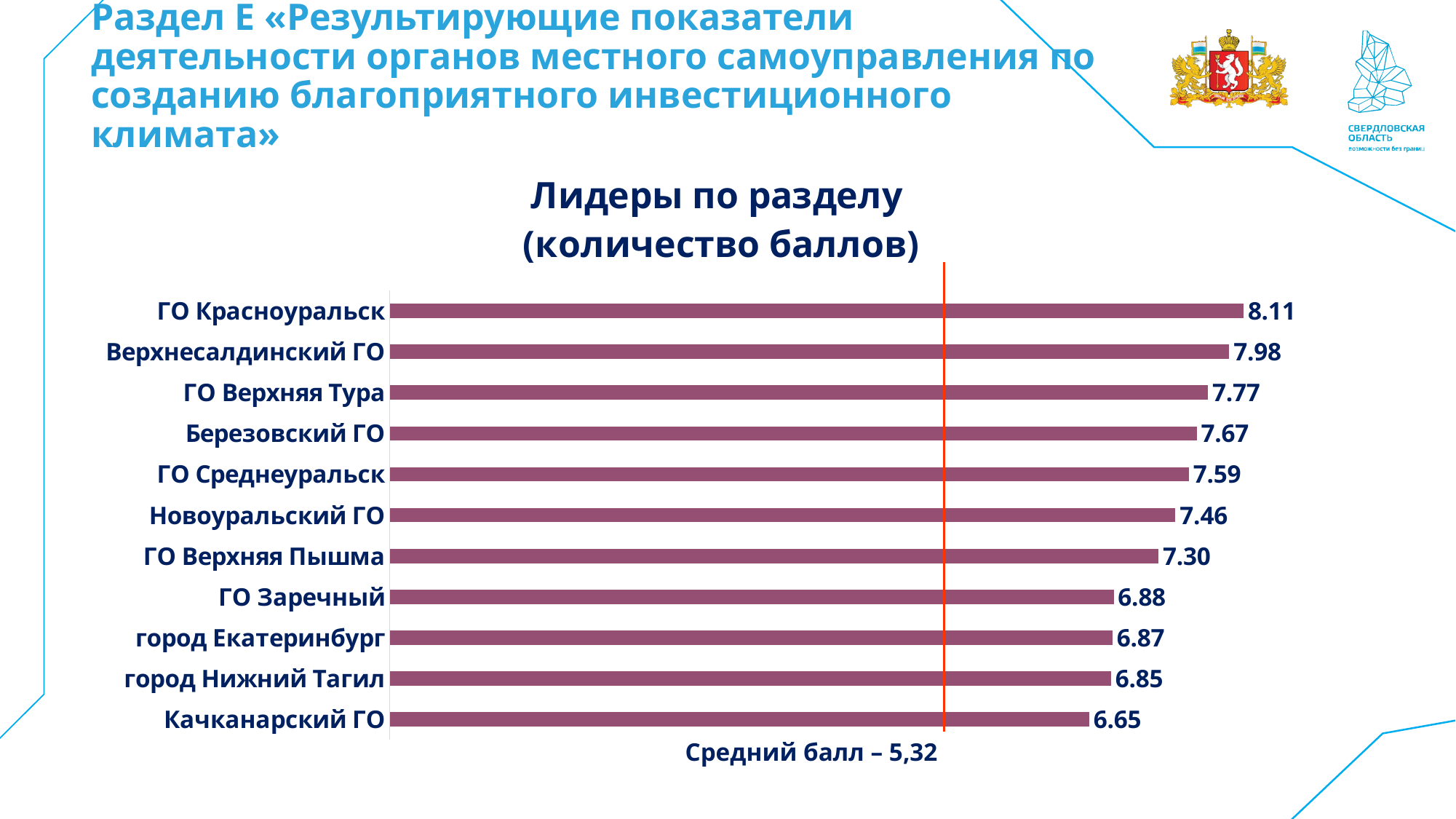
Which is larger, the value for Березовский ГО or the value for ГО Заречный? Березовский ГО What is the difference between the values for ГО Красноуральск and Качканарский ГО? 1.46 What is the title of the chart? Лидеры по разделу (количество баллов) What kind of chart is shown on the slide? bar chart What is the value for город Екатеринбург? 6.87 What is the value for ГО Красноуральск? 8.11 Which category has the highest value? ГО Красноуральск Which category has the lowest value? Качканарский ГО What is the difference between the values for Верхнесалдинский ГО and ГО Верхняя Пышма? 0.68 How many categories are shown in the chart? 11 What is the value for Новоуральский ГО? 7.46 What average score (Средний балл) is stated below the chart? 5,32